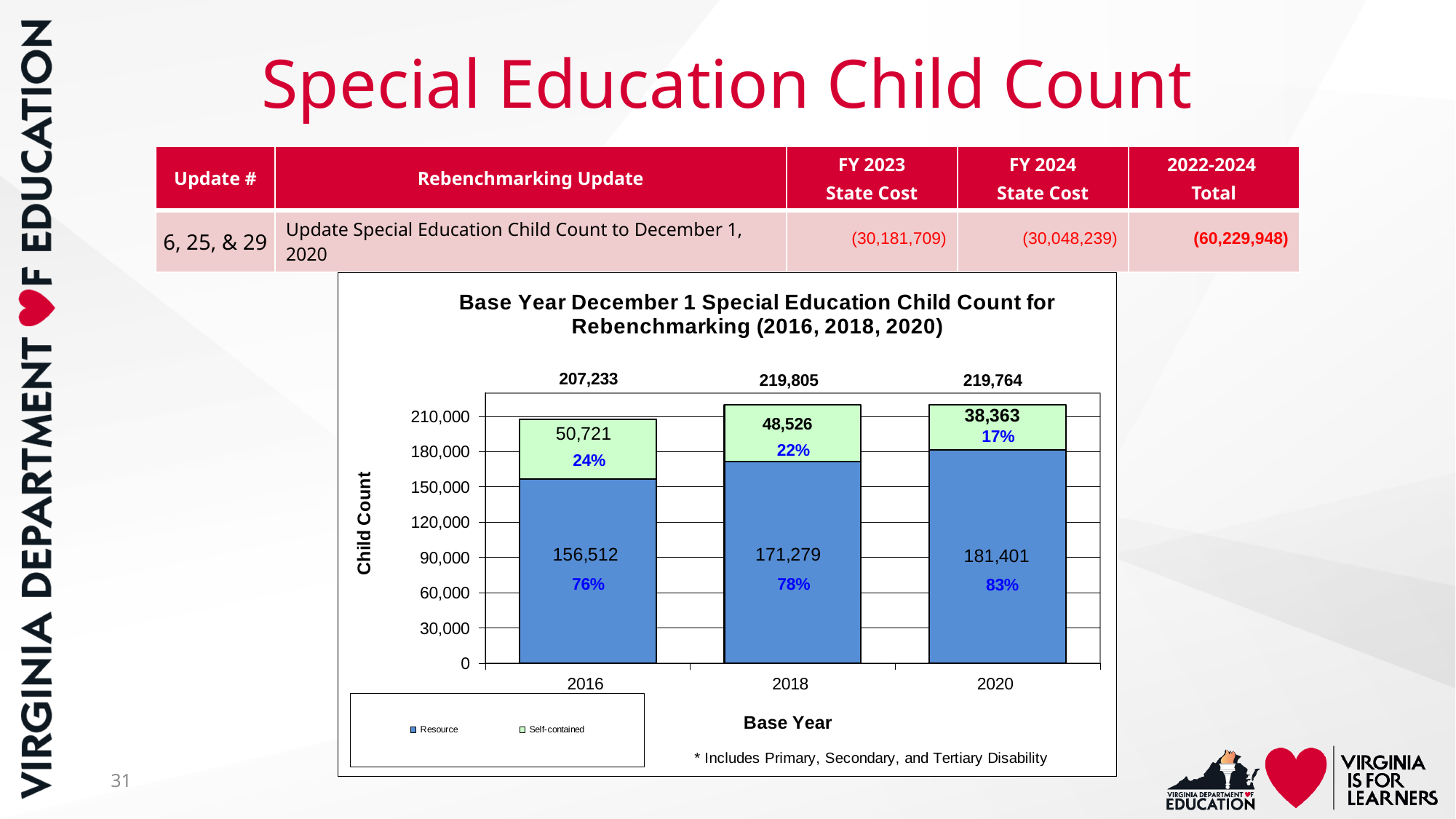
What percentage of the 2020 child count is Self-contained? 17% How many series does the legend list? 2 What is the Self-contained child count for base year 2016? 50,721 Which base year has the lowest Self-contained child count? 2020 How many base years are shown on the x axis? 3 Which base year has the highest Resource child count? 2020 What is the Resource child count for base year 2018? 171,279 What is the total child count shown above the 2016 bar? 207,233 Is the Self-contained child count larger in 2016 or in 2020? 2016 Does the Resource child count rise or fall from 2016 to 2020? Rise What is the difference between the Resource child count in 2020 and in 2016? 24,889 What type of chart is shown on the slide? Stacked bar chart